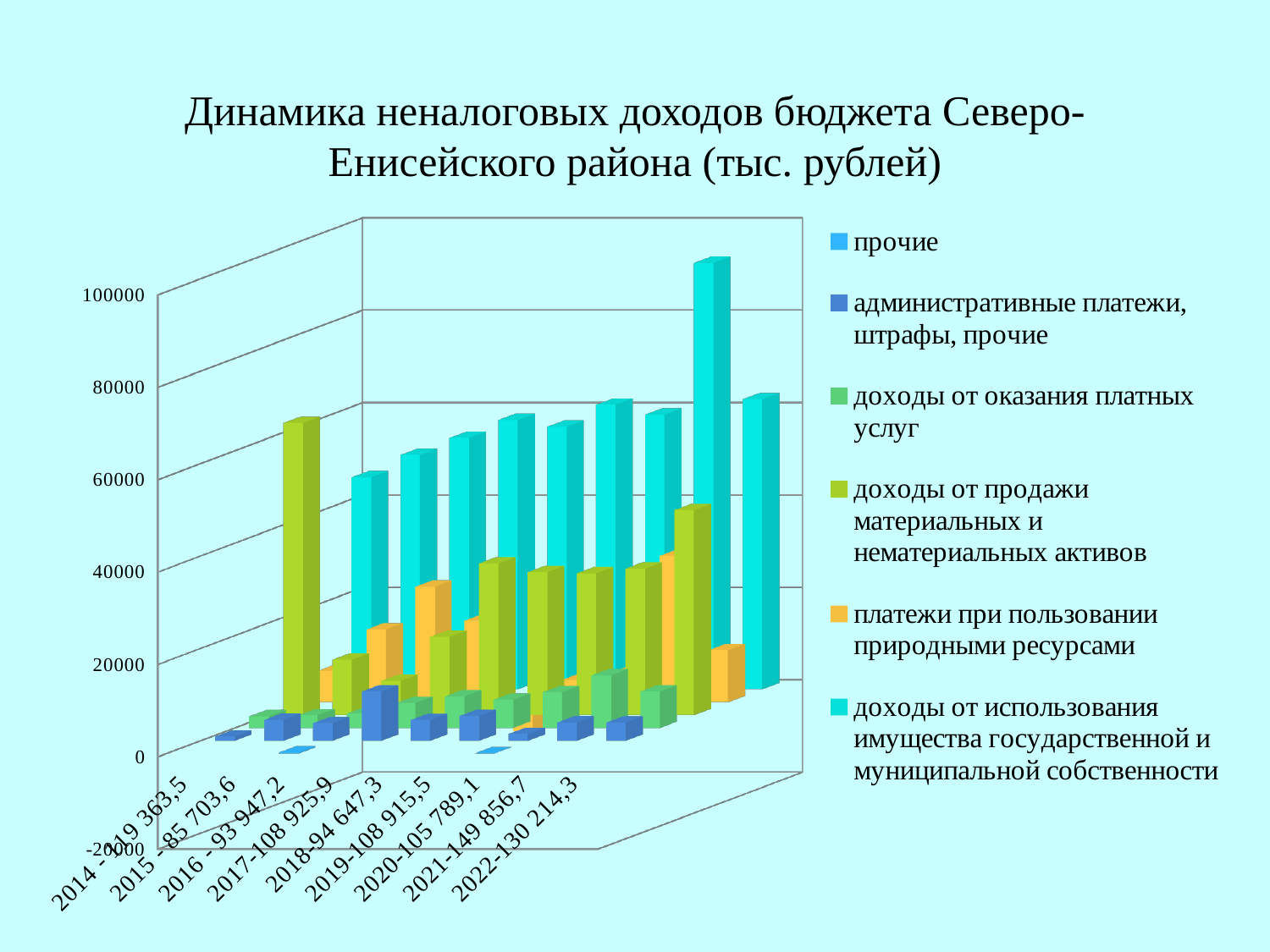
How many year categories are shown on the x axis? 9 Which series has the tallest bar in 2021? доходы от использования имущества государственной и муниципальной собственности What total is printed in the x-axis label for 2021? 149 856,7 In which year is the bar for 'доходы от использования имущества государственной и муниципальной собственности' the highest? 2021 Is the value for 'доходы от использования имущества государственной и муниципальной собственности' in 2021 greater or less than 80000? greater How many series does the legend list? 6 What is the title of the chart? Динамика неналоговых доходов бюджета Северо-Енисейского района (тыс. рублей) Which series is shown in cyan according to the legend? доходы от использования имущества государственной и муниципальной собственности What total is printed in the x-axis label for 2014? 119 363,5 Is the value for 'административные платежи, штрафы, прочие' in 2015 greater or less than 20000? less Is the value for 'доходы от продажи материальных и нематериальных активов' in 2016 greater or less than 40000? less What kind of chart is shown on the slide? bar chart